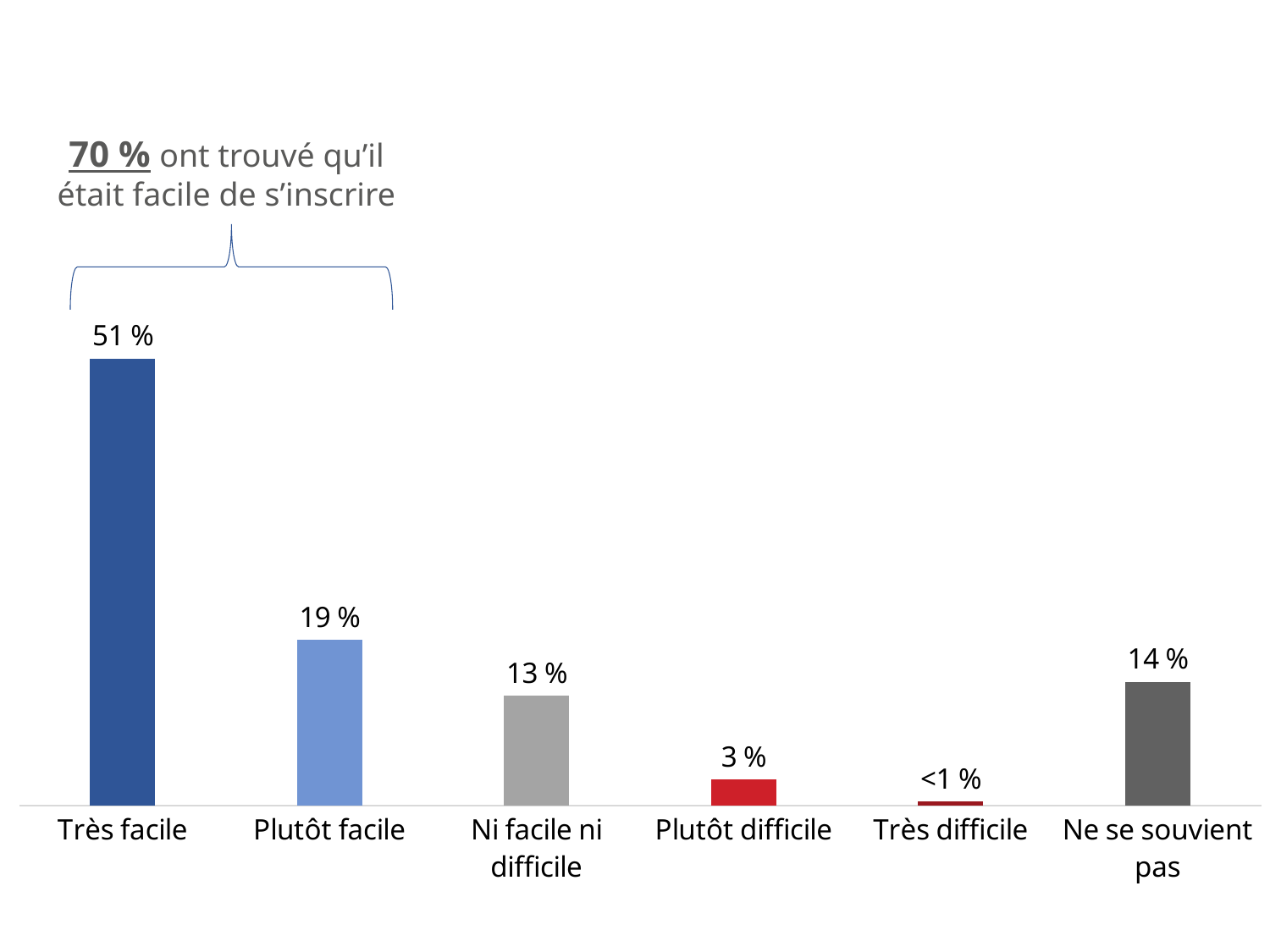
What kind of chart is this? Bar chart What is the value for "Très facile"? 51 % How many categories are shown on the x axis? 6 What is the value shown for "Très difficile"? <1 % What is the value for "Ne se souvient pas"? 14 % What is the value for "Plutôt facile"? 19 % What is the difference between the values for "Très facile" and "Plutôt facile"? 32 % According to the annotation above the chart, what percentage found it easy to register ("ont trouvé qu'il était facile de s'inscrire")? 70 % Which category has the highest value? Très facile Which is larger, the value for "Ne se souvient pas" or the value for "Ni facile ni difficile"? Ne se souvient pas What is the value for "Ni facile ni difficile"? 13 % Which category has the lowest value? Très difficile